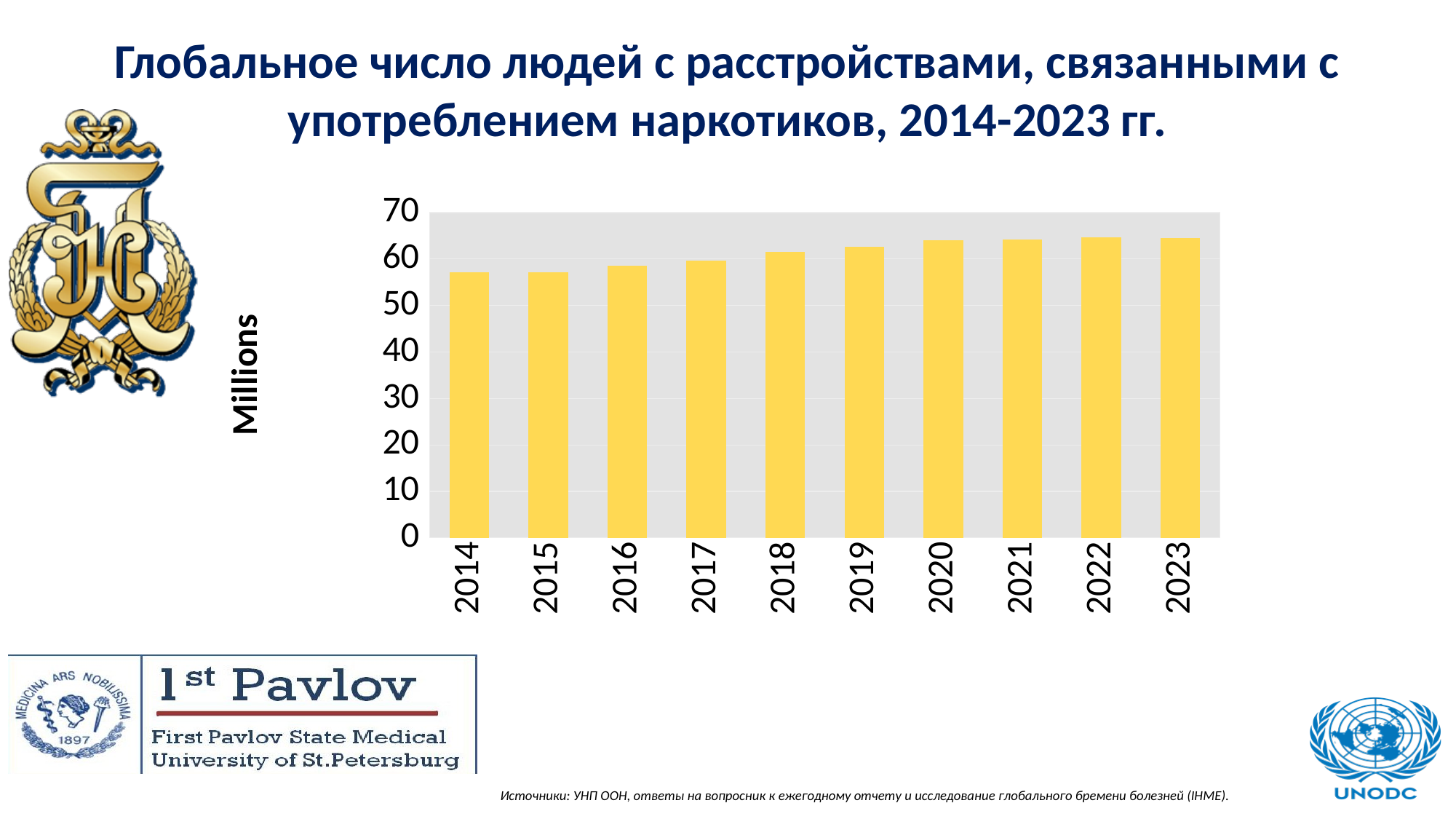
What kind of chart is shown on the slide? bar chart Do the values in the chart generally rise or fall from 2014 to 2023? rise Is the value for 2014 greater or less than 60? less Is the value for 2014 greater or less than 50? greater Is the value for 2023 greater or less than 60? greater What colour are the bars in the chart? yellow Which year has the larger value, 2014 or 2023? 2023 How many years are plotted on the x axis of the chart? 10 What is the label on the vertical axis of the chart? Millions Which year has the larger value, 2015 or 2019? 2019